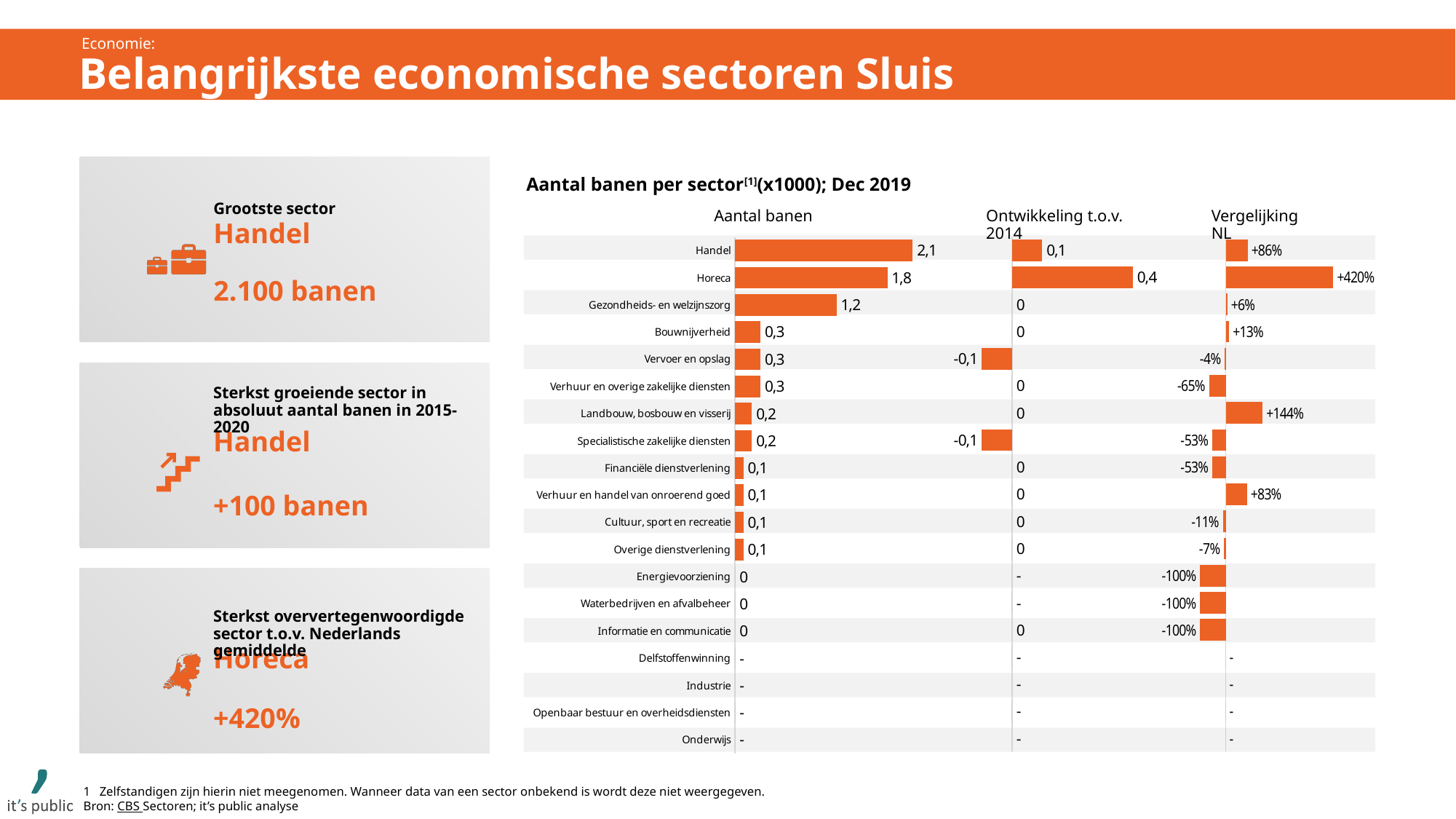
In the 'Vergelijking NL' column, what is the value for Horeca? +420% What is the difference in 'Aantal banen' between Handel and Horeca? 0,3 What is the title of the chart? Aantal banen per sector (x1000); Dec 2019 How many sectors are listed in the chart? 19 In the 'Ontwikkeling t.o.v. 2014' column, what is the value for Horeca? 0,4 What kind of chart is used to show the 'Aantal banen per sector' data? Bar chart In the 'Aantal banen' column, what is the value for Handel? 2,1 In the 'Ontwikkeling t.o.v. 2014' column, what is the value for Vervoer en opslag? -0,1 In the 'Aantal banen' column, which is larger: Gezondheids- en welzijnszorg or Bouwnijverheid? Gezondheids- en welzijnszorg Which sector has the highest value in the 'Aantal banen' column? Handel In the 'Vergelijking NL' column, what is the value for Landbouw, bosbouw en visserij? +144% Which sector has the highest value in the 'Vergelijking NL' column? Horeca